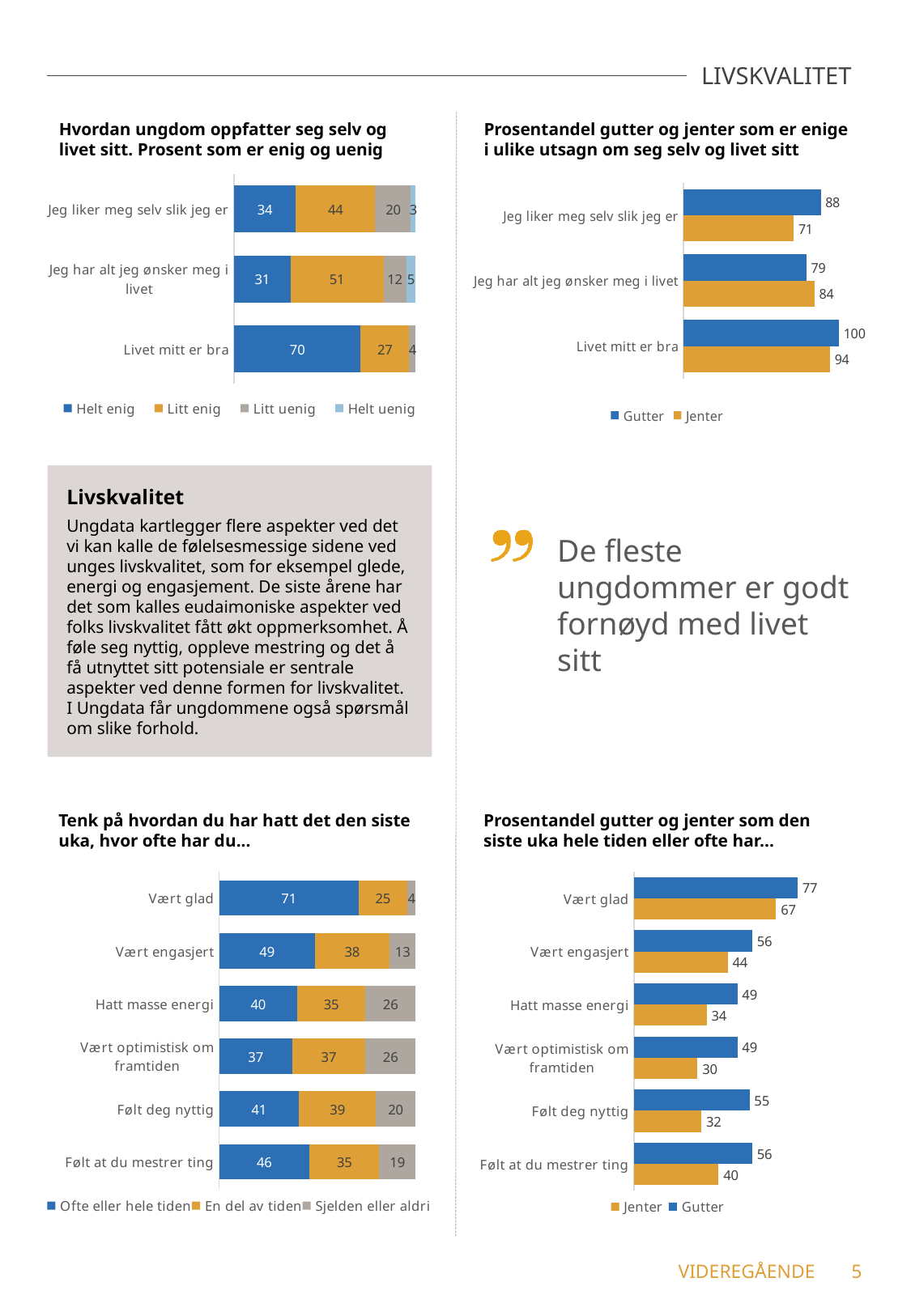
In the chart titled 'Tenk på hvordan du har hatt det den siste uka, hvor ofte har du...', how many categories are shown? 6 In the chart titled 'Prosentandel gutter og jenter som den siste uka hele tiden eller ofte har...', what is the Jenter value for 'Vært optimistisk om framtiden'? 30 In the chart titled 'Tenk på hvordan du har hatt det den siste uka, hvor ofte har du...', which category has the highest 'Ofte eller hele tiden' value? Vært glad In the chart titled 'Hvordan ungdom oppfatter seg selv og livet sitt', how many series does the legend list? 4 In the chart titled 'Hvordan ungdom oppfatter seg selv og livet sitt', what is the 'Helt enig' value for 'Livet mitt er bra'? 70 In the chart titled 'Tenk på hvordan du har hatt det den siste uka, hvor ofte har du...', what is the 'Sjelden eller aldri' value for 'Følt deg nyttig'? 20 In the chart titled 'Hvordan ungdom oppfatter seg selv og livet sitt', what is the 'Litt enig' value for 'Jeg har alt jeg ønsker meg i livet'? 51 In the chart titled 'Prosentandel gutter og jenter som er enige i ulike utsagn om seg selv og livet sitt', which is larger for 'Jeg har alt jeg ønsker meg i livet', Gutter or Jenter? Jenter What type of chart is the one titled 'Prosentandel gutter og jenter som den siste uka hele tiden eller ofte har...'? Bar chart In the chart titled 'Prosentandel gutter og jenter som den siste uka hele tiden eller ofte har...', what is the difference between Gutter and Jenter for 'Følt deg nyttig'? 23 In the chart titled 'Prosentandel gutter og jenter som er enige i ulike utsagn om seg selv og livet sitt', what is the difference between Gutter and Jenter for 'Jeg liker meg selv slik jeg er'? 17 In the chart titled 'Prosentandel gutter og jenter som er enige i ulike utsagn om seg selv og livet sitt', what is the Gutter value for 'Livet mitt er bra'? 100